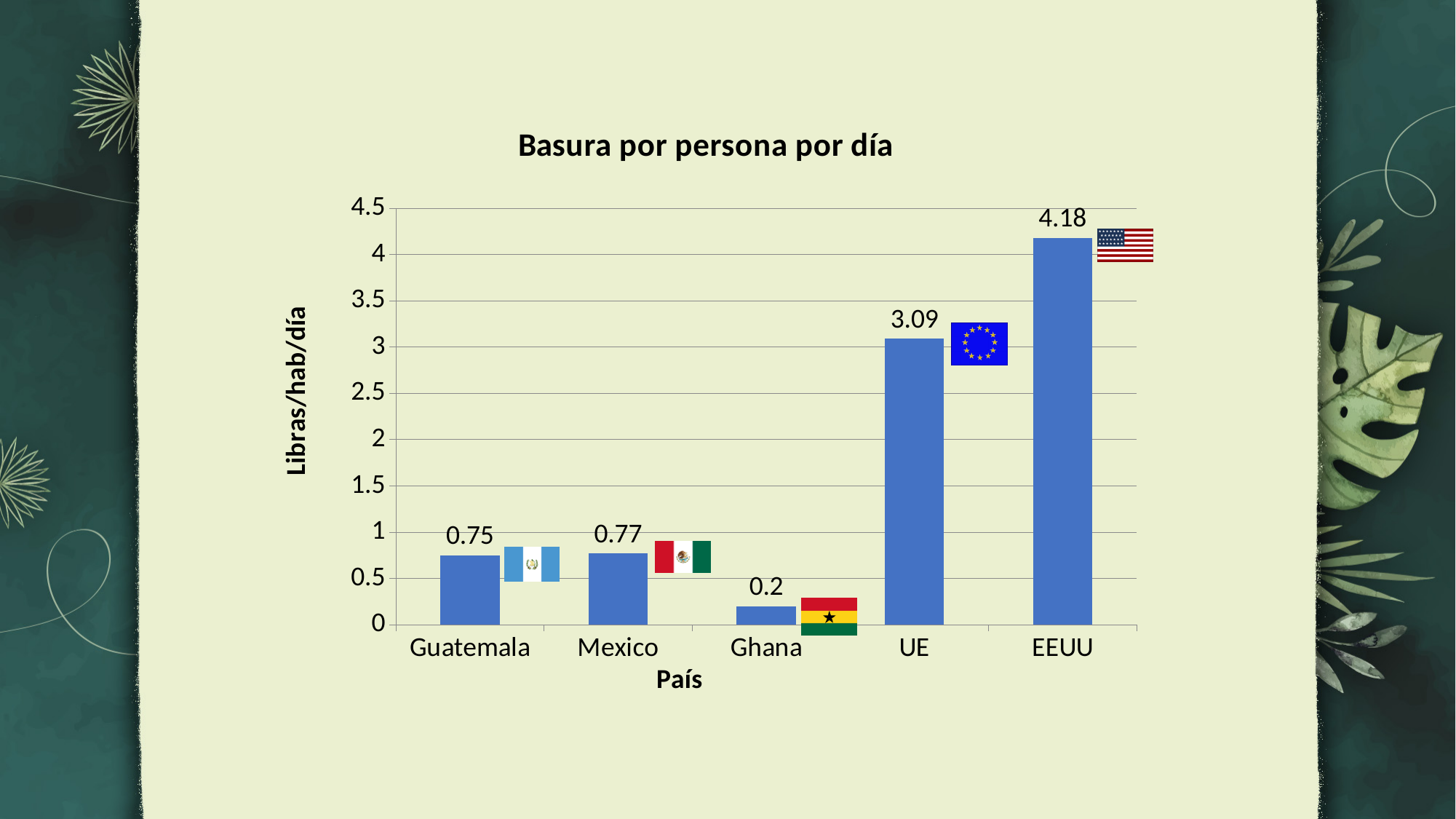
What kind of chart is this? bar chart How many countries are shown on the x axis? 5 What is the difference between the values for EEUU and UE? 1.09 What is the value for Guatemala? 0.75 Which country has the lowest value? Ghana What is the label of the y axis? Libras/hab/día What is the value for Ghana? 0.2 Is the value for EEUU greater or less than 4? greater What is the value for UE? 3.09 Which country has the highest value? EEUU What is the title of the chart? Basura por persona por día Which is larger, the value for UE or the value for Mexico? UE